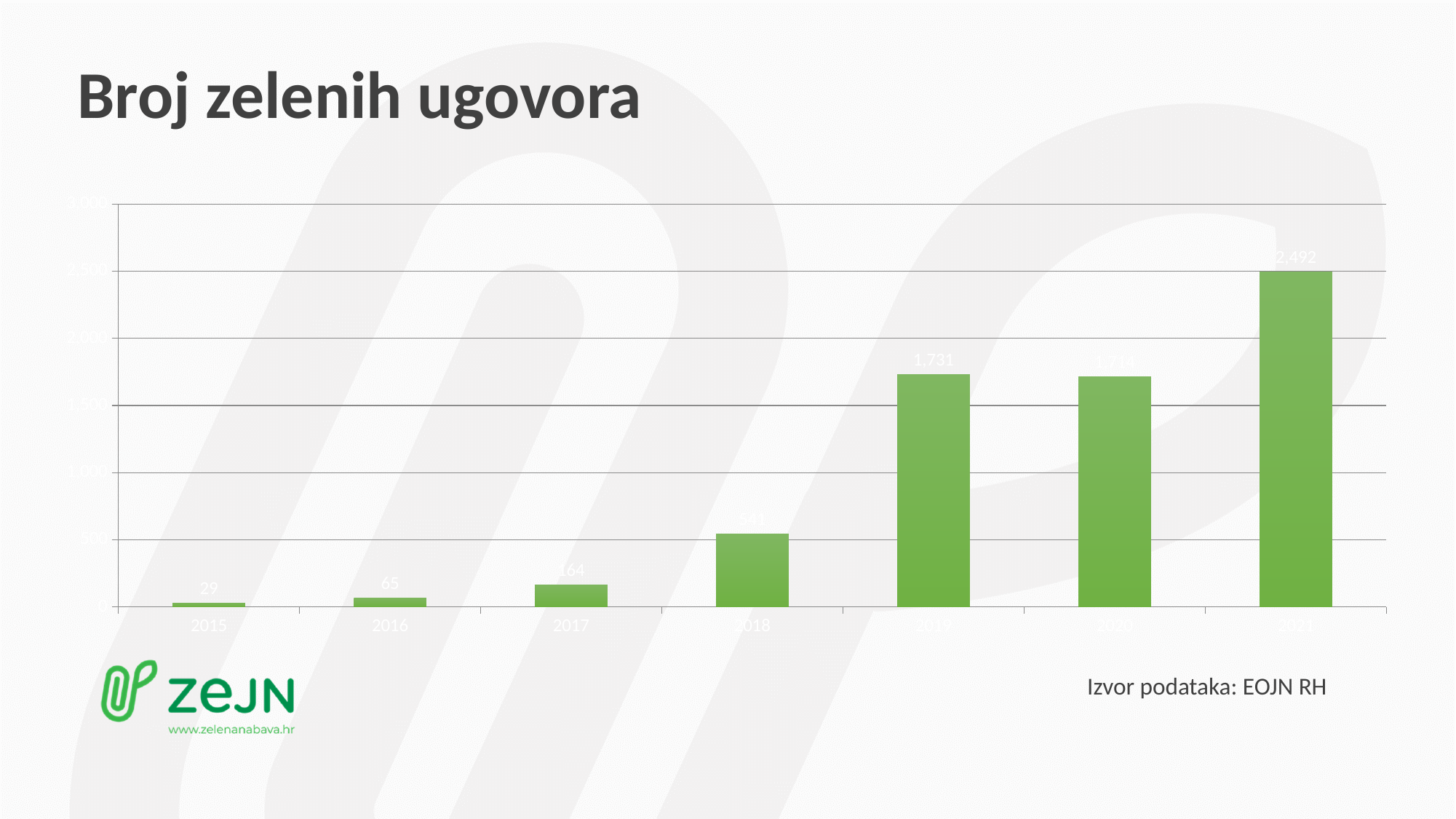
Is the value for 2020 greater or less than 1.500? greater What kind of chart is shown on the slide? bar chart What is the value for 2018? 541 What is the value for 2021? 2,492 What is the difference between the values for 2018 and 2017? 377 What is the value for 2015? 29 What is the value for 2017? 164 What is the title of the chart? Broj zelenih ugovora Which year has the lowest value? 2015 What is the value for 2016? 65 Which year has the highest value? 2021 How many years (bars) are shown in the chart? 7